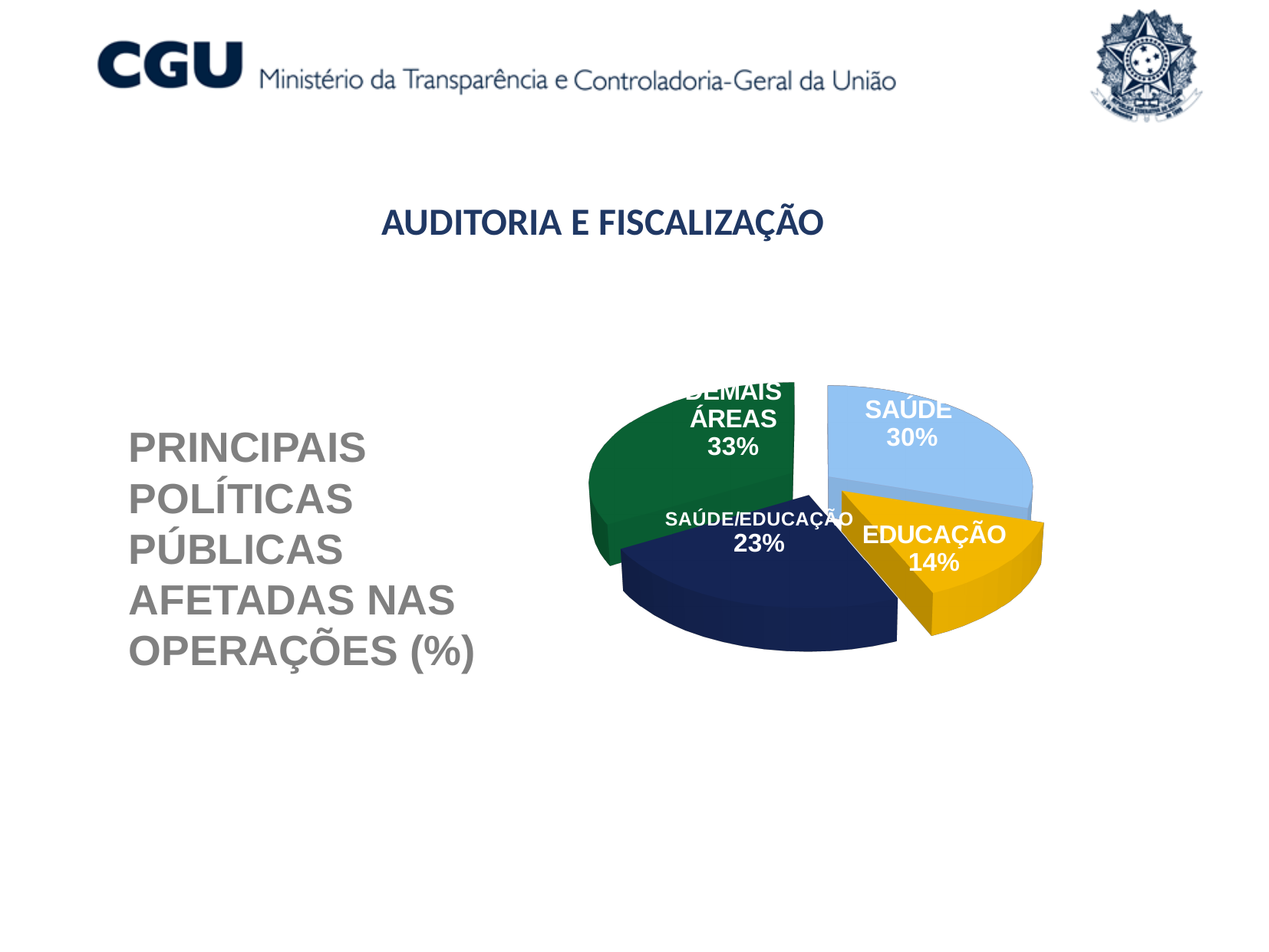
What percentage does the DEMAIS ÁREAS slice represent? 33% What percentage does the SAÚDE/EDUCAÇÃO slice represent? 23% Which slice of the pie chart is the largest? DEMAIS ÁREAS What kind of chart is shown on the slide? Pie chart What is the combined share of SAÚDE and EDUCAÇÃO? 44% What percentage does the SAÚDE slice represent? 30% Which is larger, SAÚDE or SAÚDE/EDUCAÇÃO? SAÚDE What colour is the EDUCAÇÃO slice? Yellow Which slice of the pie chart is the smallest? EDUCAÇÃO What percentage does the EDUCAÇÃO slice represent? 14% What is the difference in percentage points between SAÚDE and EDUCAÇÃO? 16 How many slices does the pie chart have? 4